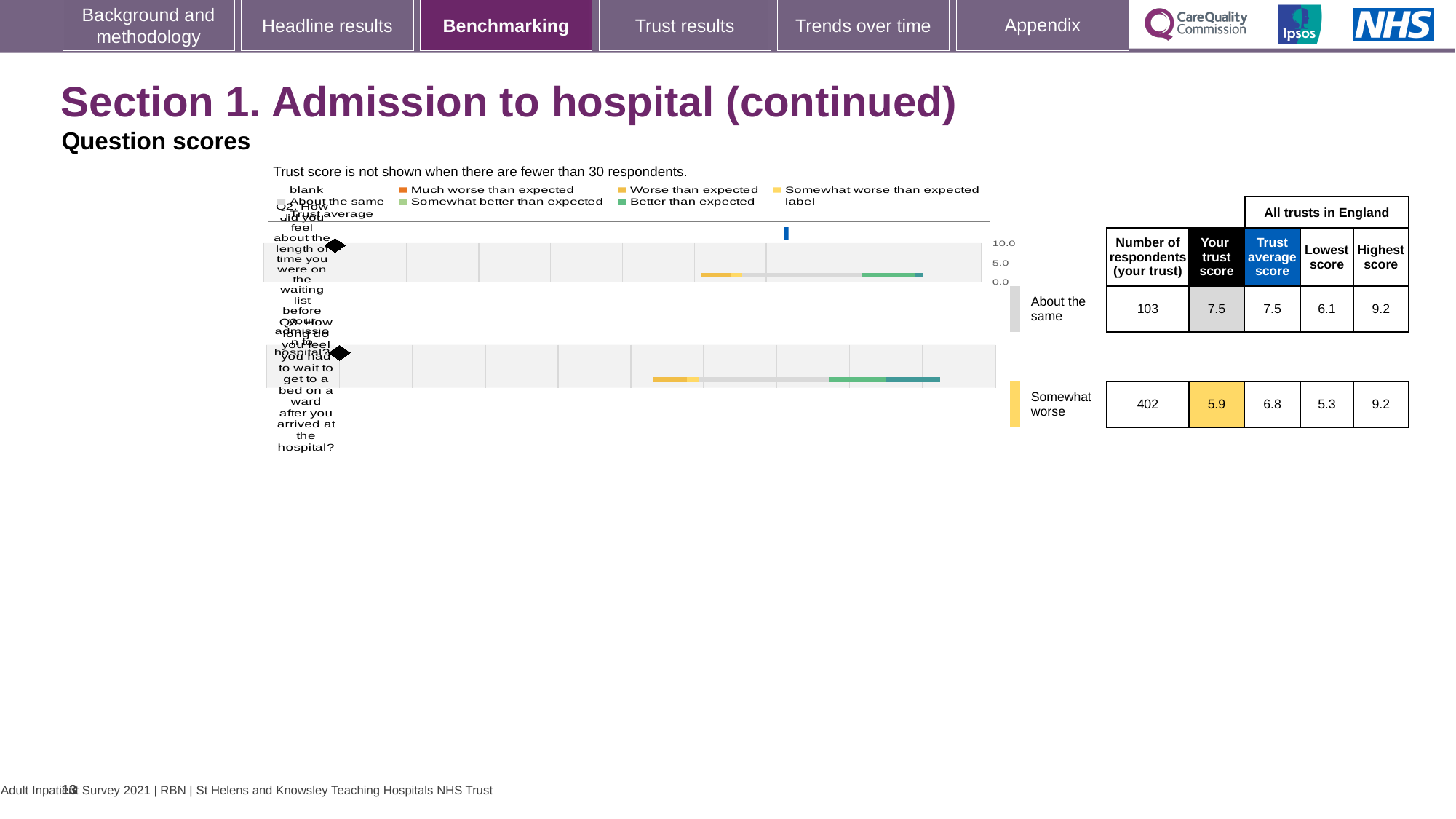
How many questions are plotted on this slide? 2 Which question has the higher trust score, Q2 or Q3? Q2 For Q3, what is the difference between the all-trusts average score and this trust's score? 0.9 What is the trust score for Q3 (how long you had to wait to get to a bed on a ward)? 5.9 Which benchmark category is this trust's Q3 score placed in? Somewhat worse What is the trust average score across all trusts in England for Q3? 6.8 What is the highest score across all trusts in England for Q3? 9.2 How many respondents answered Q2 at this trust? 103 What is the lowest score across all trusts in England for Q2? 6.1 How many respondents answered Q3 at this trust? 402 What is the trust score for Q2 (length of time on the waiting list before admission)? 7.5 Which benchmark category is this trust's Q2 score placed in? About the same